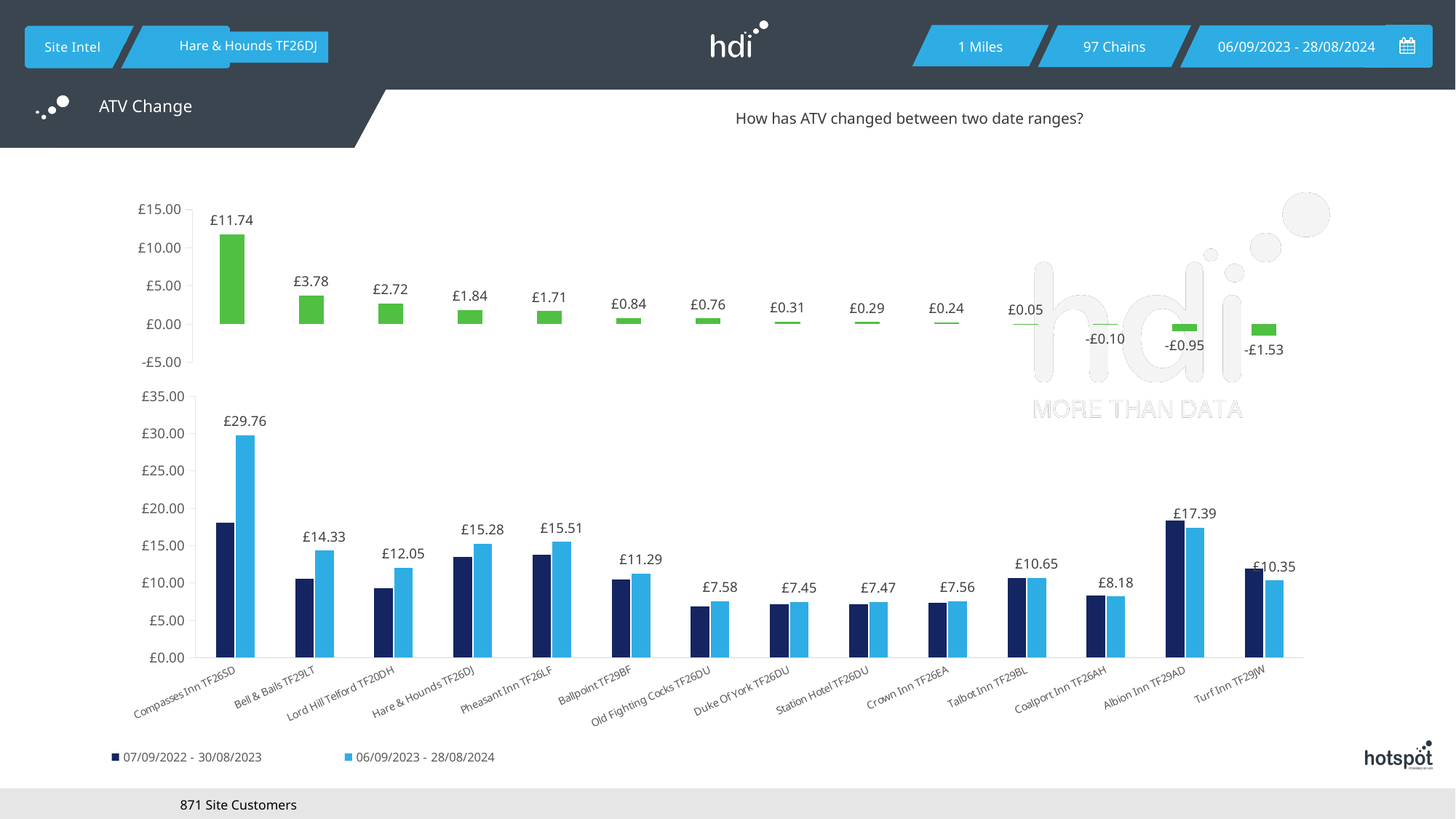
In the top chart, what is the ATV change for Turf Inn TF29JW? -£1.53 In the top chart, which site has the lowest ATV change? Turf Inn TF29JW In the top chart, do the values rise or fall moving left to right along the x axis? fall In the top chart, what is the difference between the ATV change for Compasses Inn TF26SD and Bell & Bails TF29LT? £7.96 How many series does the legend of the bottom chart list? 2 How many sites are shown on the x axis of the bottom chart? 14 In the bottom chart, is the 07/09/2022 - 30/08/2023 value for Compasses Inn TF26SD greater or less than £15.00? greater In the bottom chart, what is the ATV for Albion Inn TF29AD in the 06/09/2023 - 28/08/2024 period? £17.39 In the bottom chart, what is the ATV for Hare & Hounds TF26DJ in the 06/09/2023 - 28/08/2024 period? £15.28 In the bottom chart, is the 06/09/2023 - 28/08/2024 ATV larger for Pheasant Inn TF26LF or Ballpoint TF29BF? Pheasant Inn TF26LF In the top chart, what is the ATV change for Compasses Inn TF26SD? £11.74 In the bottom chart, which site has the highest ATV in the 06/09/2023 - 28/08/2024 period? Compasses Inn TF26SD